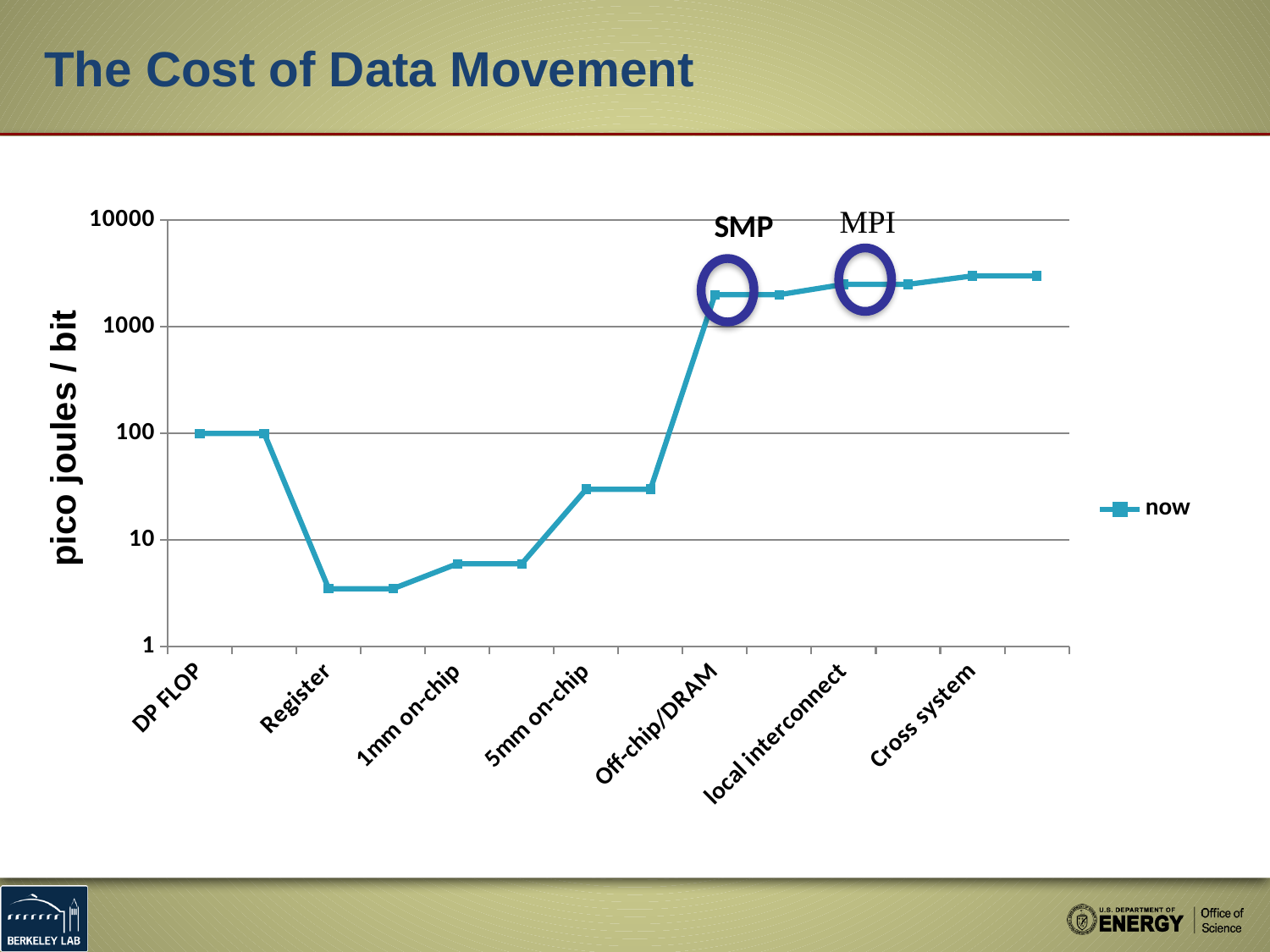
What is the value for DP FLOP in pico joules / bit? 100 Which is larger, the value for DP FLOP or the value for 5mm on-chip? DP FLOP How many category labels are shown on the x axis? 7 What is the name of the series in the legend? now From Off-chip/DRAM to Cross system, do the values rise or fall? rise Which category has the lowest value? Register How many series does the legend list? 1 What is the label of the y axis? pico joules / bit Which category has the highest value? Cross system What kind of chart is shown on the slide? line chart Is the value for Off-chip/DRAM greater or less than 1000? greater Is the value for Register greater or less than 10? less